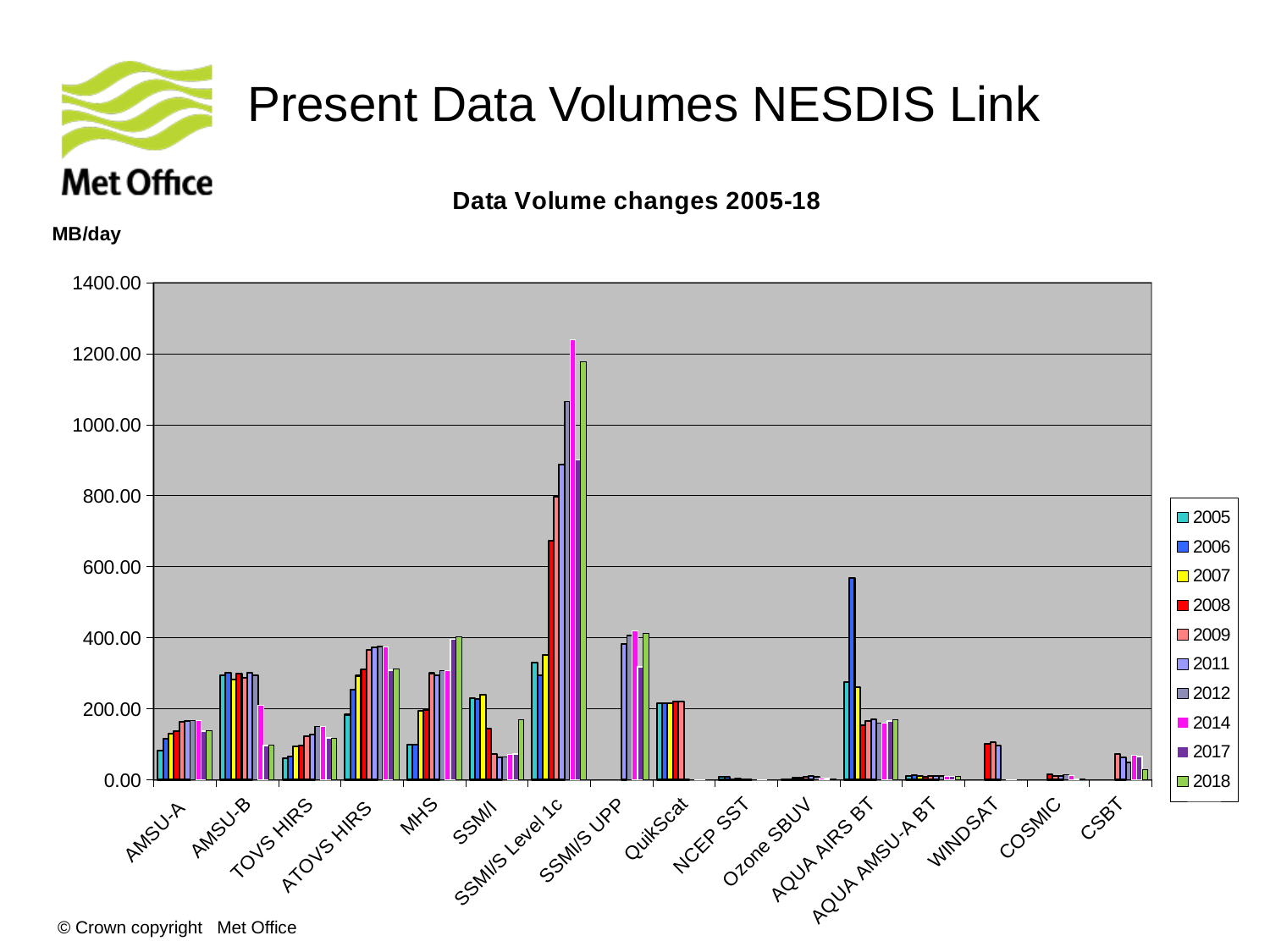
Which category contains the tallest bar in the chart? SSMI/S Level 1c For AQUA AIRS BT, which year has the highest value? 2006 Which is larger, the 2006 value for AMSU-B or the 2006 value for AMSU-A? AMSU-B Is the 2014 value for SSMI/S Level 1c greater or less than 1000.00? greater For SSMI/S Level 1c, which year has the highest value? 2014 Is the 2005 value for AMSU-A greater or less than 200.00? less How many categories are shown along the x axis? 16 Is the 2006 value for AQUA AIRS BT greater or less than 400.00? greater What is the title of the chart? Data Volume changes 2005-18 What type of chart is shown on the slide? bar chart What unit is given for the vertical axis of the chart? MB/day How many series does the legend list? 10